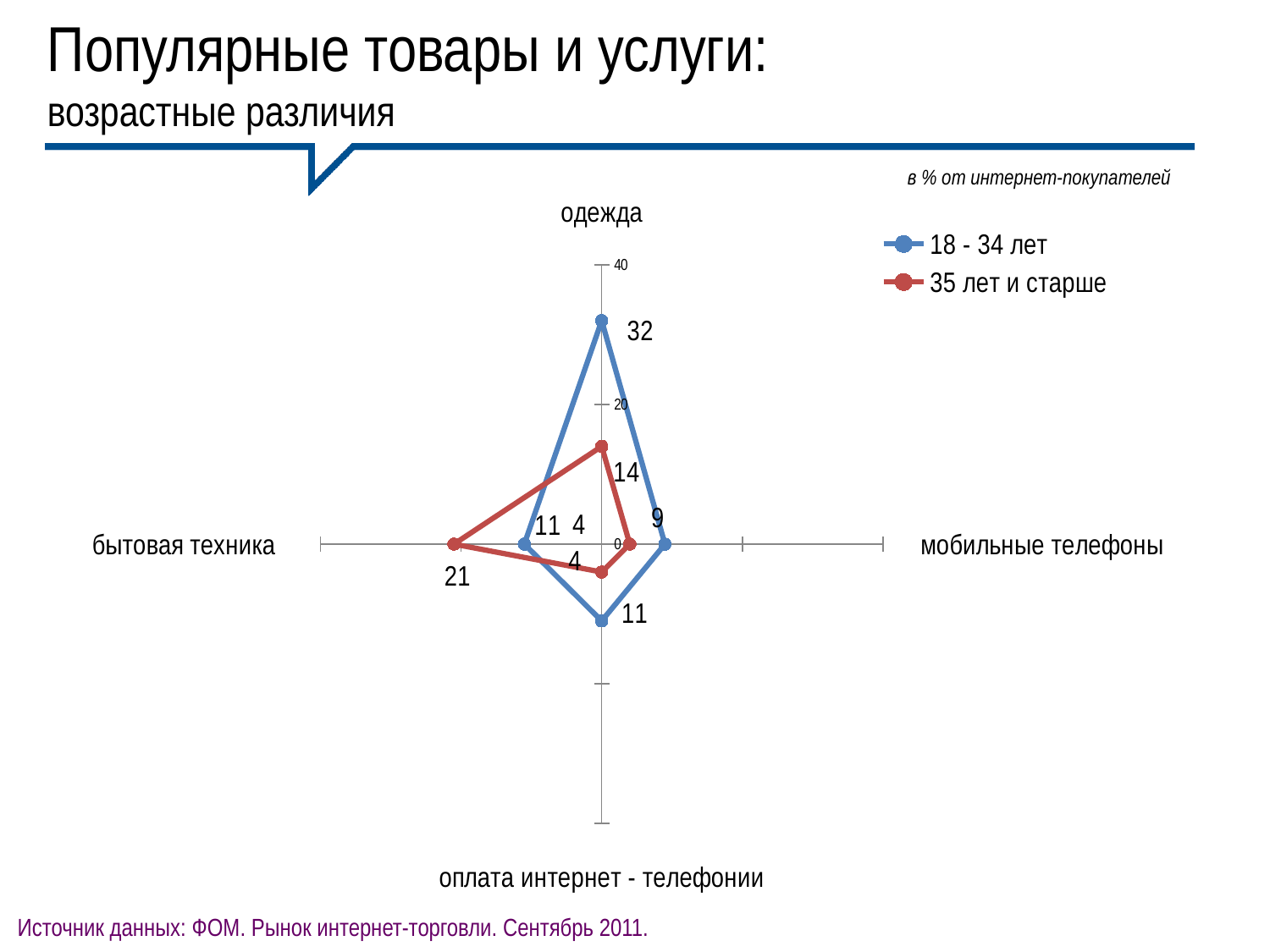
Which category has the highest value for the 35 лет и старше series? бытовая техника What is the difference between the 18 - 34 лет and 35 лет и старше values for одежда? 18 What is the value for одежда for the 18 - 34 лет series? 32 What is the value for бытовая техника for the 18 - 34 лет series? 11 How many categories are plotted on the chart? 4 What type of chart is shown on the slide? radar chart What is the value for мобильные телефоны for the 18 - 34 лет series? 9 Which category has the highest value for the 18 - 34 лет series? одежда What is the value for одежда for the 35 лет и старше series? 14 Which series has the larger value for бытовая техника? 35 лет и старше What is the value for бытовая техника for the 35 лет и старше series? 21 How many series does the legend list? 2